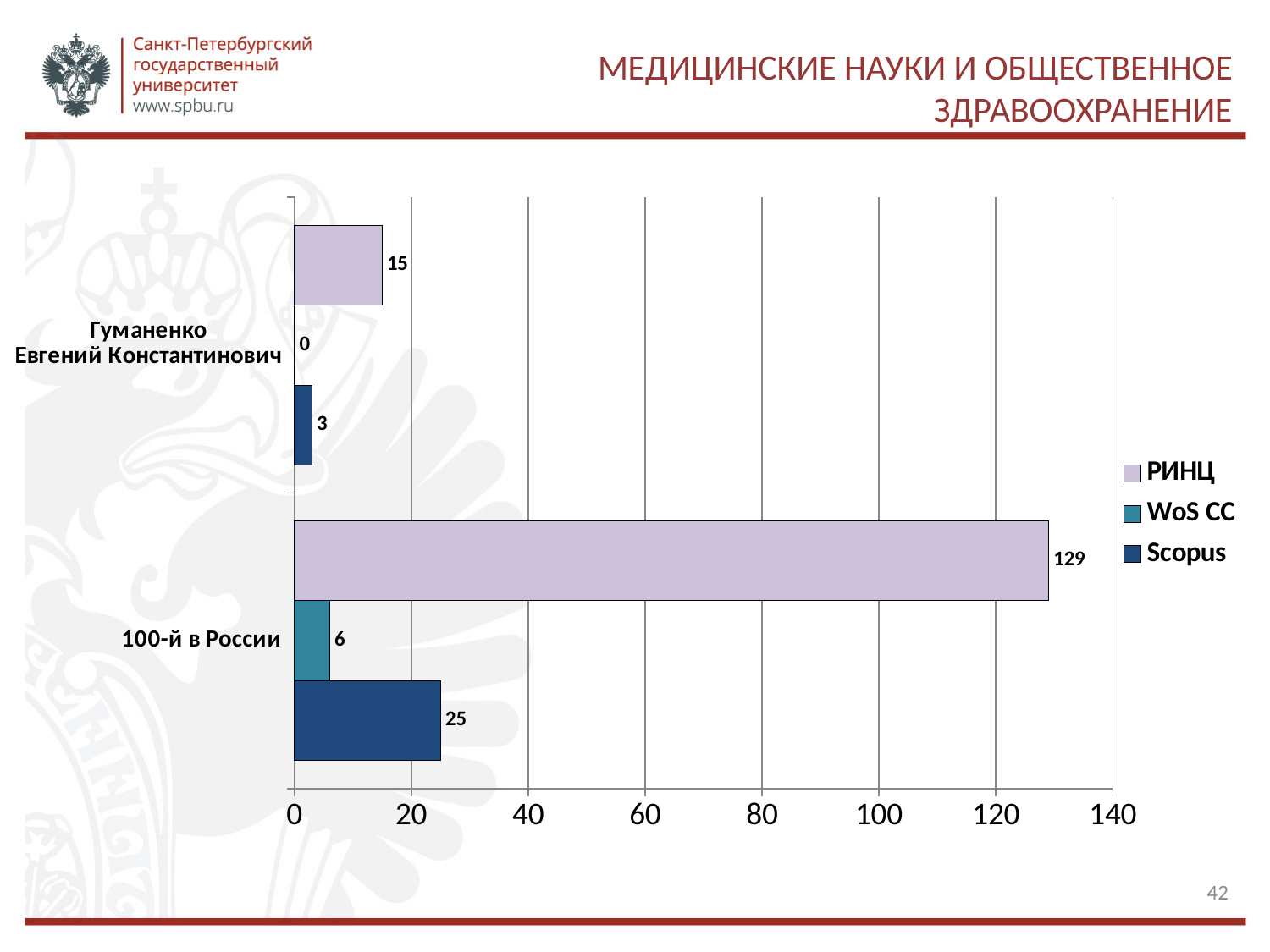
What is the РИНЦ value for 100-й в России? 129 Which series has the highest value for 100-й в России? РИНЦ What is the Scopus value for 100-й в России? 25 Which series has the lowest value for Гуманенко Евгений Константинович? WoS CC How many series does the legend list? 3 Is the РИНЦ value for 100-й в России greater or less than 120? greater How many categories are shown on the chart? 2 What is the difference between the РИНЦ values for 100-й в России and Гуманенко Евгений Константинович? 114 What kind of chart is shown on the slide? bar chart Which is larger: the Scopus value for 100-й в России or the Scopus value for Гуманенко Евгений Константинович? 100-й в России What is the WoS CC value for Гуманенко Евгений Константинович? 0 What is the РИНЦ value for Гуманенко Евгений Константинович? 15